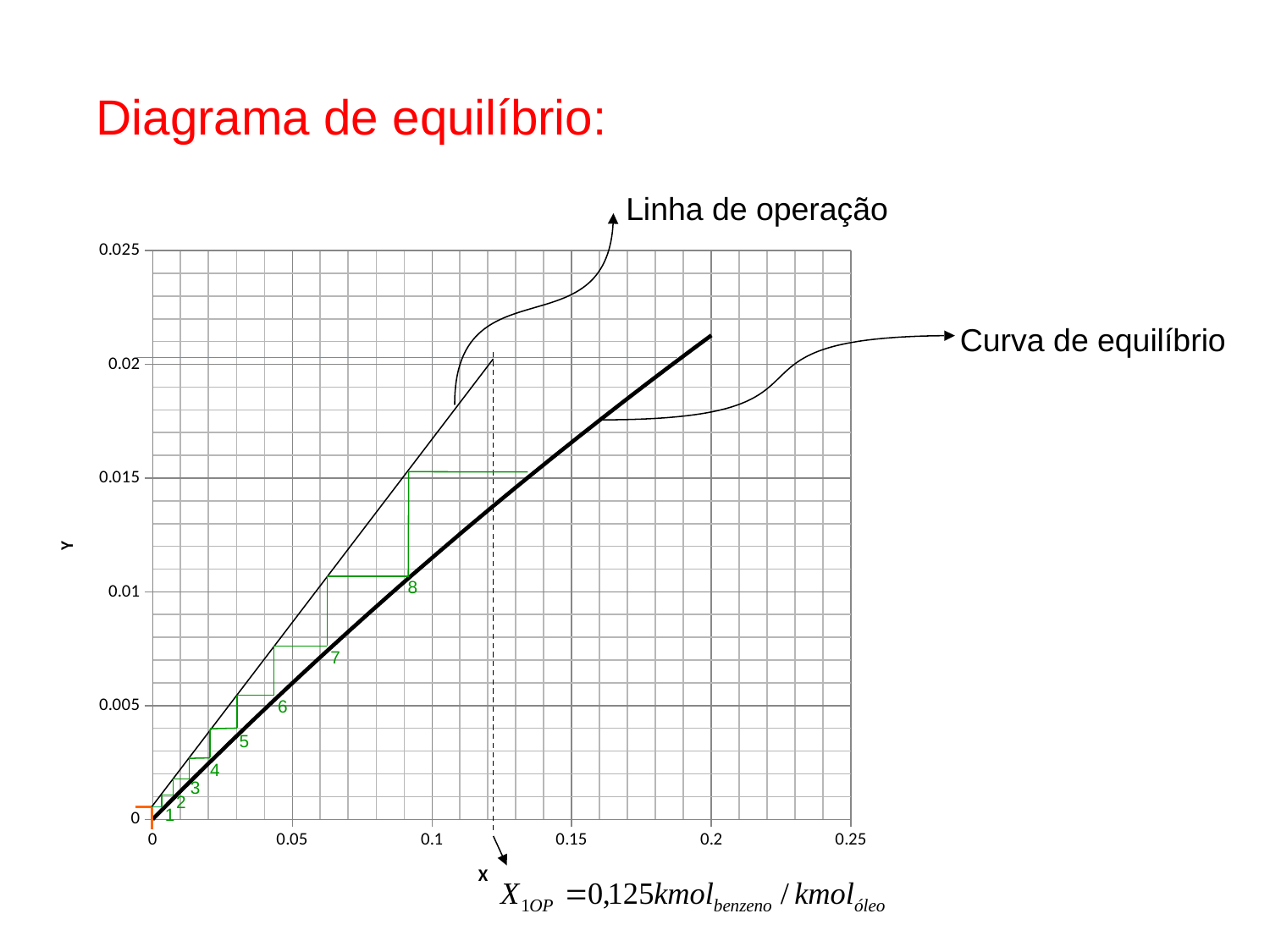
Is the value of the equilibrium curve at X = 0.1 greater or less than 0.015? less What label is given to the thin straight line in the chart? Linha de operação What is the highest tick value shown on the Y axis? 0.025 What is the title of the slide containing the chart? Diagrama de equilíbrio: Do the values of the equilibrium curve rise or fall as X increases? rise Is the value of the equilibrium curve at X = 0.05 greater or less than 0.01? less Is the value of the operating line at X = 0.1 greater or less than 0.015? greater How many stages (numbered steps) are drawn between the operating line and the equilibrium curve? 8 What is the value of X1OP indicated below the chart? 0,125 kmol benzeno / kmol óleo What kind of chart is shown on the slide? line chart What is the highest tick value shown on the X axis? 0.25 At X = 0.1, which is higher: the operating line or the equilibrium curve? operating line